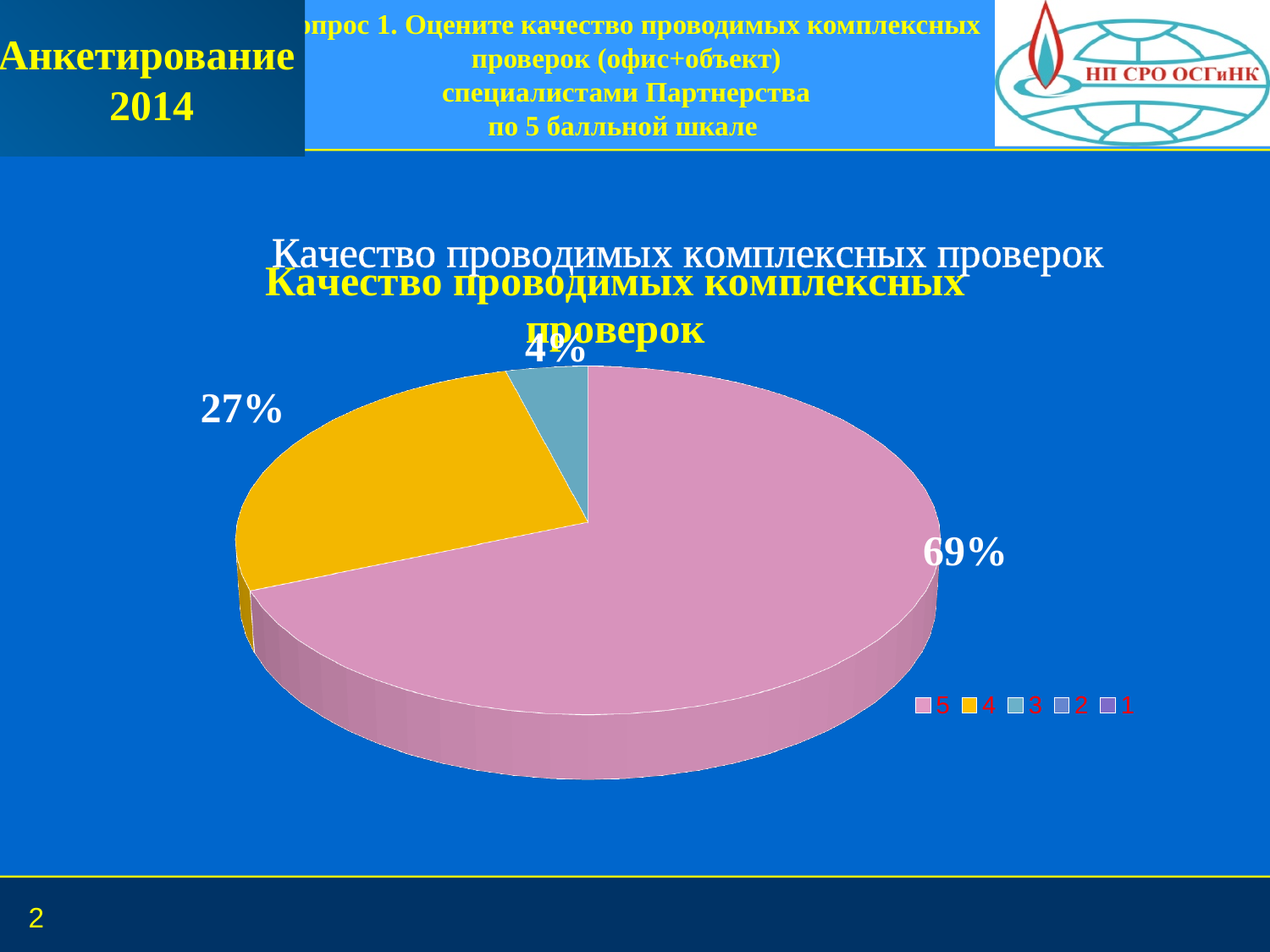
Which slice is larger: rating 4 or rating 3? 4 What colour is the slice for rating 5? pink What is the difference in percentage points between the rating 5 slice and the rating 4 slice? 42 What share of the pie does the rating 5 slice take? 69% What type of chart is shown on the slide? pie chart What is the difference in percentage points between the rating 4 slice and the rating 3 slice? 23 How many entries does the legend list? 5 What share of the pie does the rating 4 slice take? 27% What is the title of the chart? Качество проводимых комплексных проверок What share of the pie does the rating 3 slice take? 4% Which of the labelled slices has the smallest share of the pie? 3 Which rating has the largest share of the pie? 5